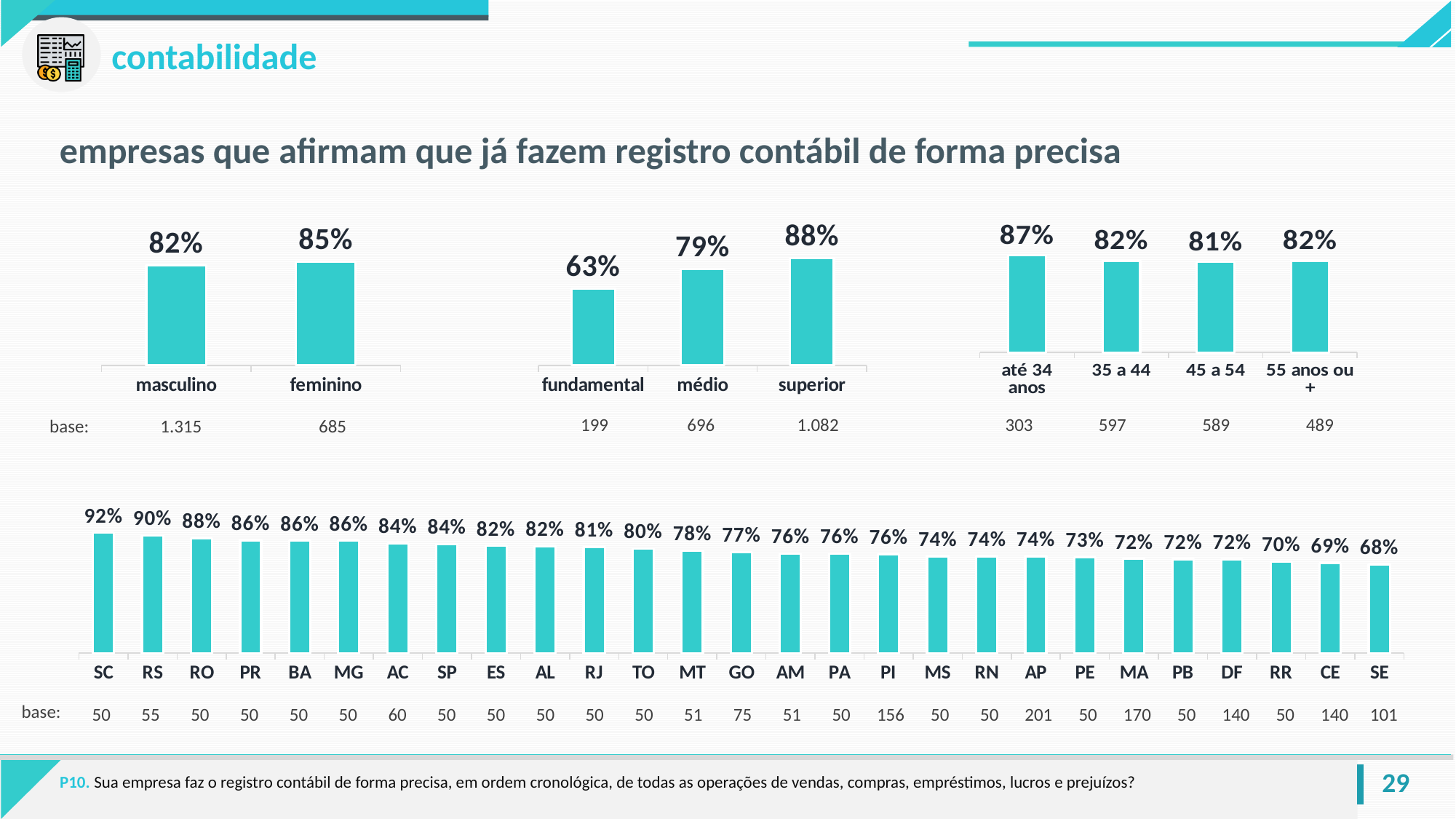
In the state chart at the bottom, how many states are shown? 27 In the education chart at the top centre, what is the difference between superior and fundamental? 25% In the education chart at the top centre, which category has the highest value? superior In the gender chart at the top left, what is the difference between feminino and masculino? 3% In the age chart at the top right, what is the value for até 34 anos? 87% In the gender chart at the top left, what is the value for feminino? 85% In the state chart at the bottom, what is the value for MT? 78% In the education chart at the top centre, what is the value for fundamental? 63% In the age chart at the top right, which age group has the lowest value? 45 a 54 In the state chart at the bottom, which state has the highest value? SC In the state chart at the bottom, which state has the lowest value? SE What type of chart is used for the state data at the bottom of the slide? bar chart